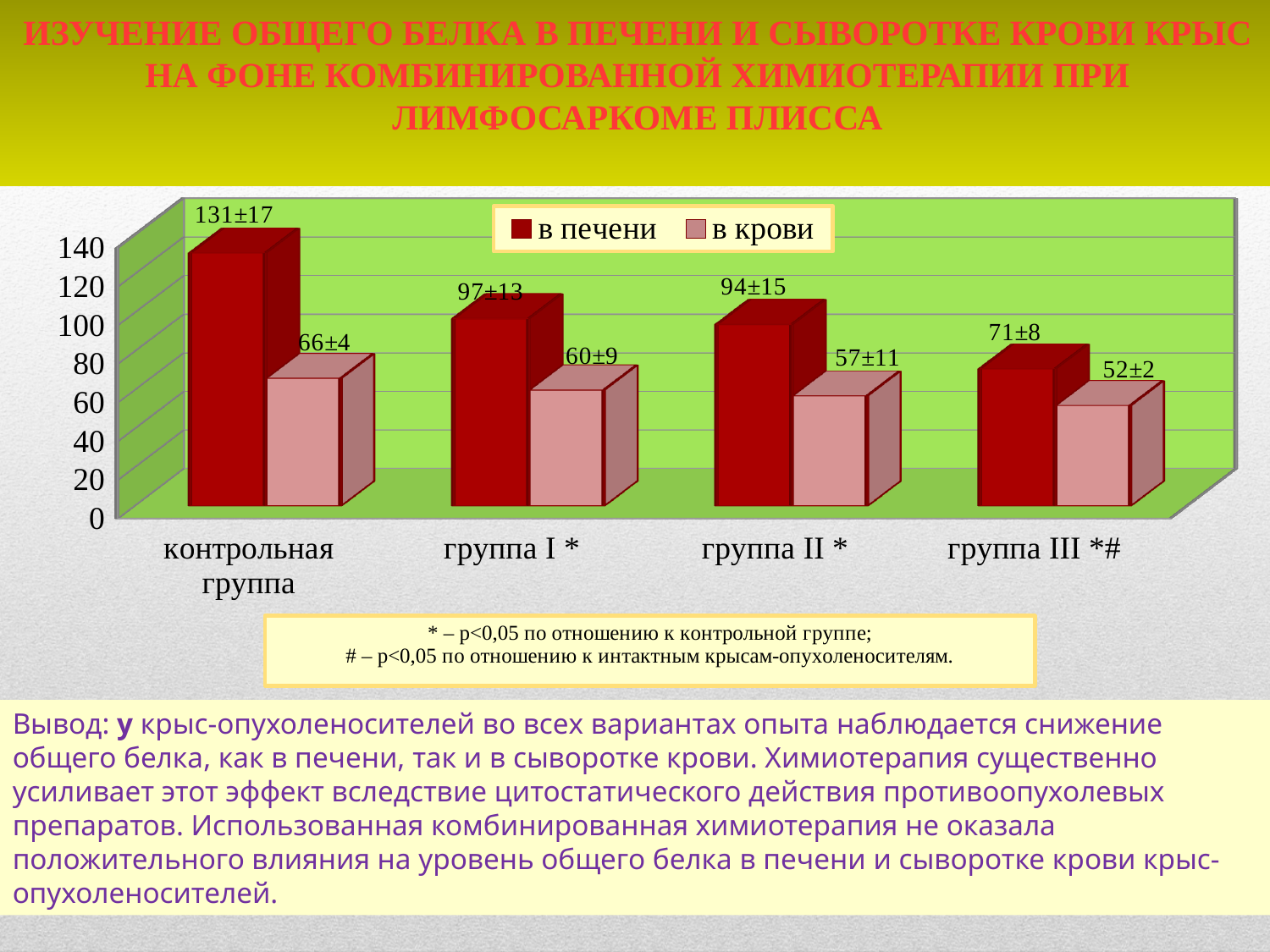
What is the value for "в крови" in группа II *? 57±11 How many groups (categories) are shown on the x axis? 4 How many series does the legend list? 2 Which group has the highest value for "в печени"? контрольная группа What is the value for "в печени" in the контрольная группа? 131±17 Which group has the lowest value for "в крови"? группа III *# Which is larger: the "в печени" value for группа I * or for группа III *#? группа I * Is the "в печени" value for the контрольная группа greater or less than 120? greater Do the "в печени" values rise or fall from the контрольная группа to группа III *#? fall What is the value for "в крови" in группа I *? 60±9 What is the value for "в печени" in группа III *#? 71±8 What kind of chart is shown on the slide? bar chart